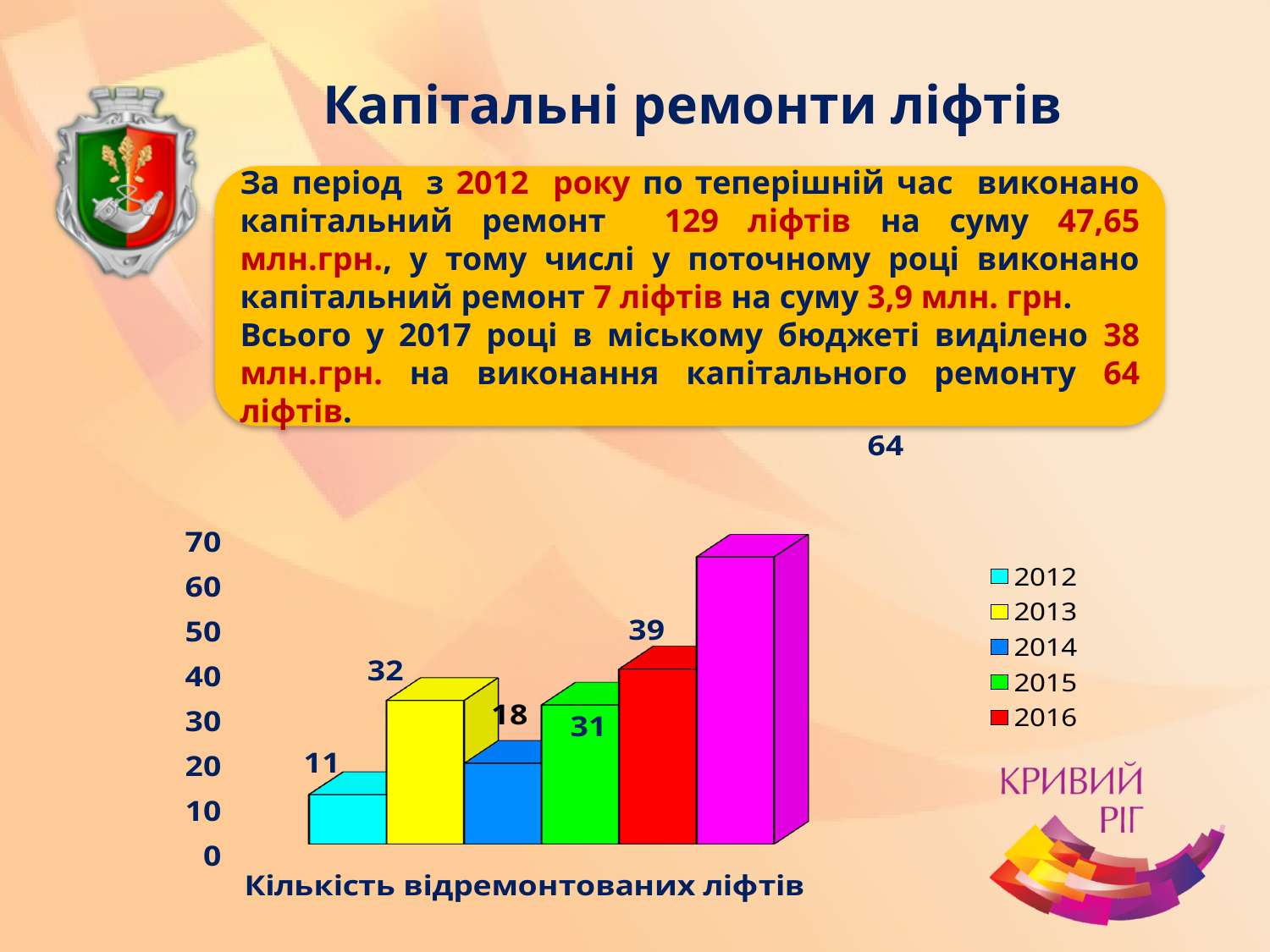
Which year in the legend has the lowest value in the chart? 2012 What is the category label shown under the bars of the chart? Кількість відремонтованих ліфтів What kind of chart is shown on the slide? bar chart What is the value for 2016 in the chart? 39 What is the value for 2012 in the chart? 11 How many series does the chart legend list? 5 Which is larger, the value for 2013 or the value for 2015? 2013 What value is labelled on the tallest (magenta, rightmost) bar in the chart? 64 What is the difference between the values for 2016 and 2012? 28 What is the value for 2013 in the chart? 32 How many bars are plotted in the chart? 6 What is the value for 2014 in the chart? 18